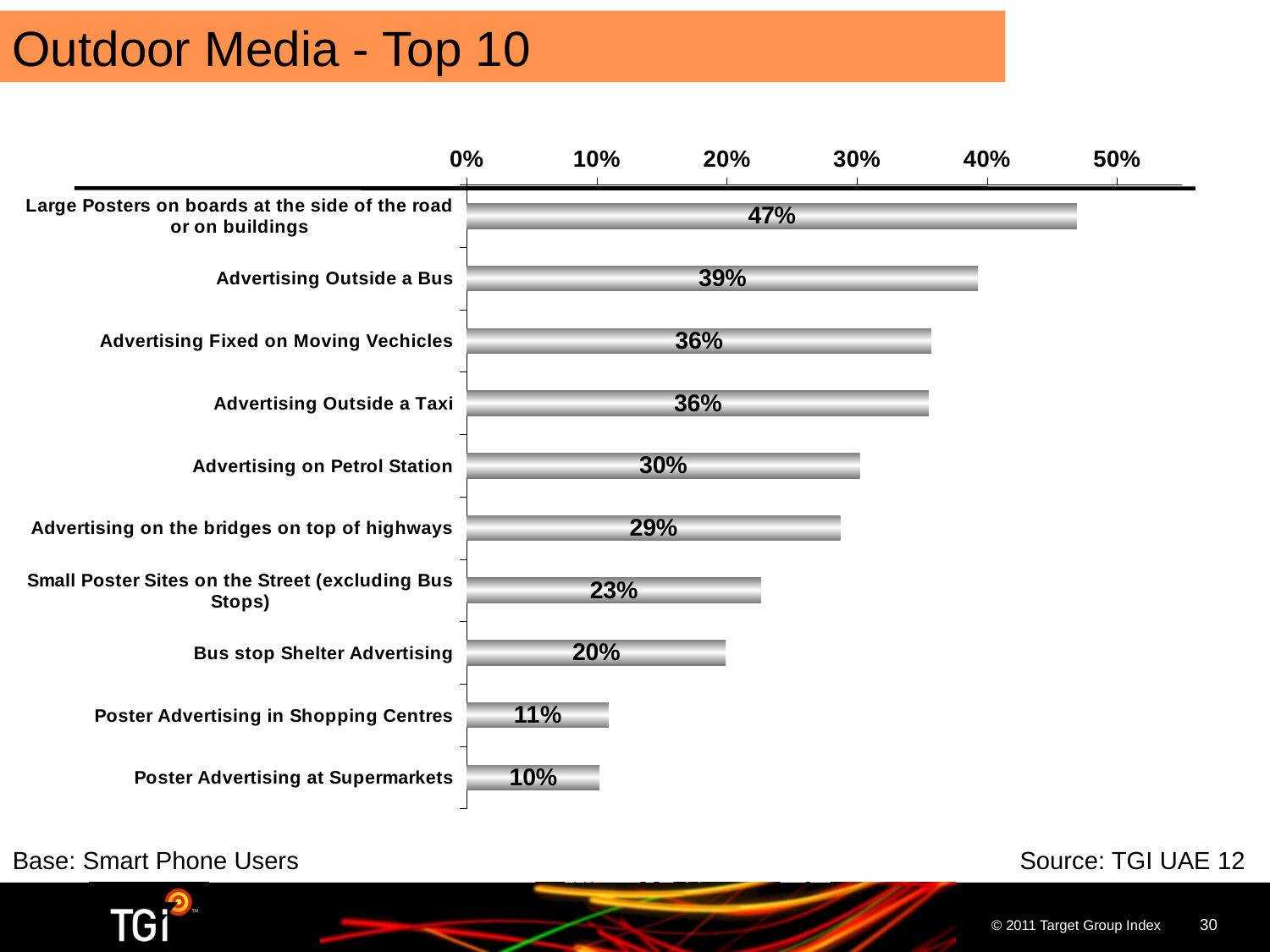
What is the title of the slide? Outdoor Media - Top 10 What is the difference between the values for Advertising Outside a Bus and Advertising on the bridges on top of highways? 10% What is the value for Advertising Outside a Bus? 39% What kind of chart is shown on the slide? bar chart What is the difference between the values for Small Poster Sites on the Street (excluding Bus Stops) and Poster Advertising in Shopping Centres? 12% How many categories are shown in the chart? 10 Which category has the lowest value? Poster Advertising at Supermarkets Which is larger, the value for Advertising on Petrol Station or the value for Bus stop Shelter Advertising? Advertising on Petrol Station What is the value for Bus stop Shelter Advertising? 20% What is the value for Advertising on Petrol Station? 30% Is the value for Advertising Outside a Taxi greater or less than 30%? greater Which category has the highest value? Large Posters on boards at the side of the road or on buildings